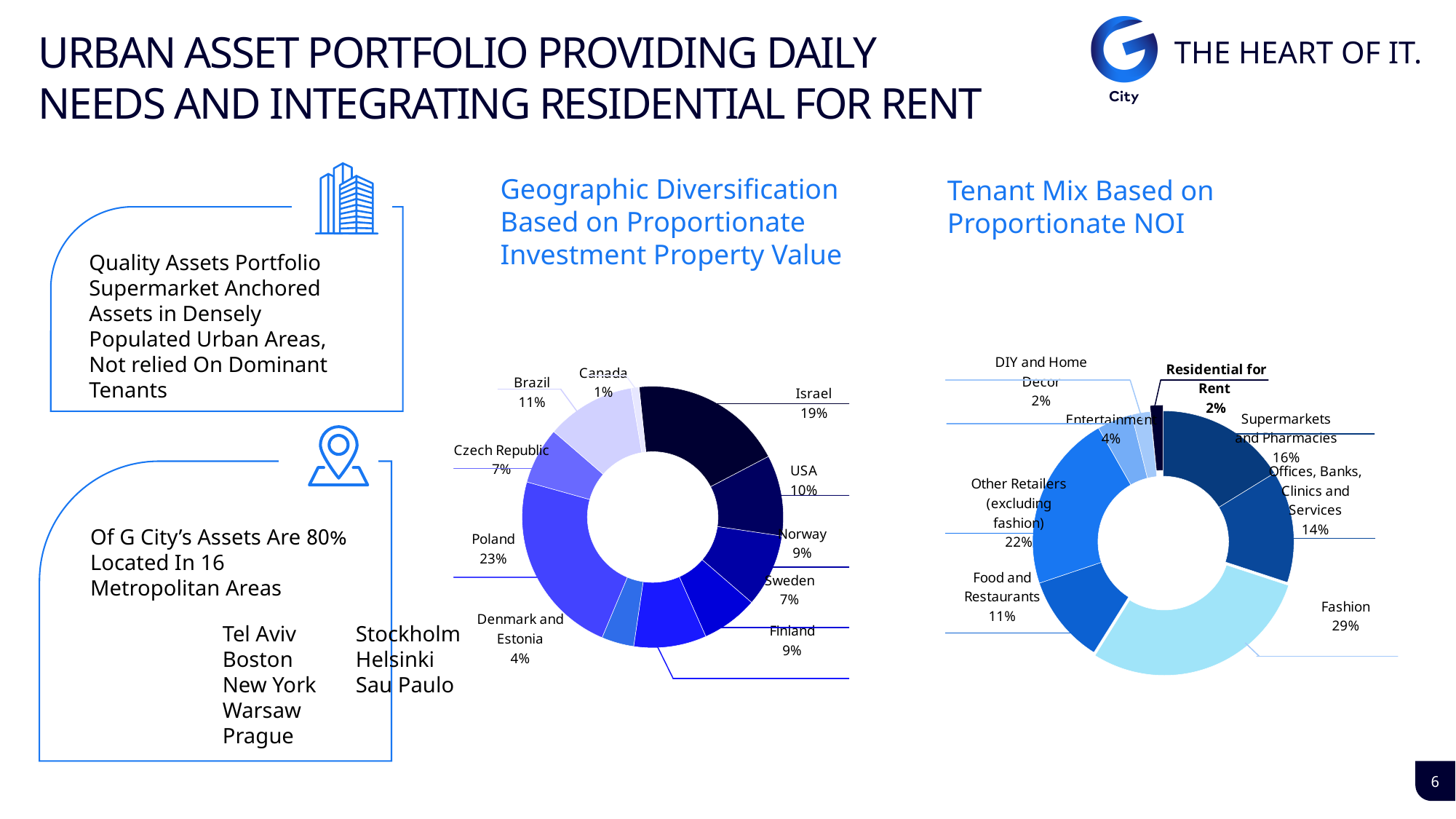
In the Tenant Mix chart, what is the difference between Other Retailers (excluding fashion) and Food and Restaurants? 11% In the Geographic Diversification chart, which country has the largest share? Poland How many tenant categories are shown in the Tenant Mix chart? 8 How many countries or regions are shown in the Geographic Diversification chart? 10 In the Tenant Mix chart, what share does Fashion have? 29% What is the title of the chart on the right of the slide? Tenant Mix Based on Proportionate NOI In the Geographic Diversification chart, what is the difference between Israel's share and Brazil's share? 8% In the Geographic Diversification chart, which country has the smallest share? Canada What kind of chart is the Geographic Diversification chart? Pie chart (donut) In the Tenant Mix chart, which tenant category has the largest share? Fashion In the Geographic Diversification chart, which is larger, the share for USA or the share for Sweden? USA In the Geographic Diversification chart, what share does Poland have? 23%